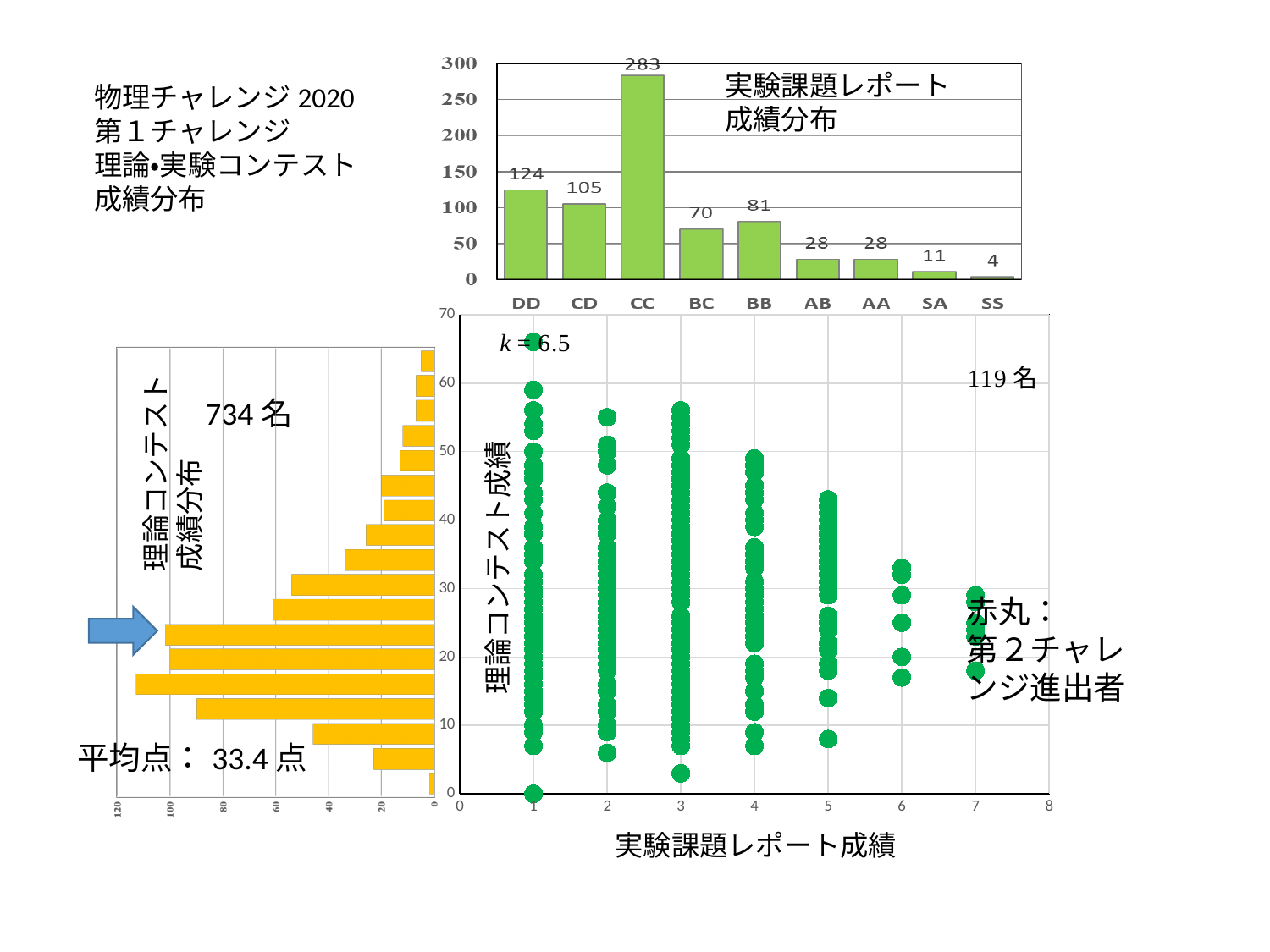
In the top bar chart 実験課題レポート成績分布, what is the value for CC? 283 What kind of chart is the chart on the left titled 理論コンテスト成績分布? bar chart What kind of chart is the large chart at the bottom right plotting 理論コンテスト成績 against 実験課題レポート成績? scatter chart In the top bar chart 実験課題レポート成績分布, what is the value for DD? 124 In the top bar chart 実験課題レポート成績分布, which category has the lowest value? SS In the top bar chart 実験課題レポート成績分布, what is the value for SA? 11 In the top bar chart 実験課題レポート成績分布, which is larger, the value for BB or the value for BC? BB In the top bar chart 実験課題レポート成績分布, which category has the highest value? CC In the top bar chart 実験課題レポート成績分布, how many categories are shown on the x axis? 9 In the top bar chart 実験課題レポート成績分布, what is the difference between the values for DD and CD? 19 What kind of chart is the top chart 実験課題レポート成績分布? bar chart In the scatter chart at the bottom right, what is the x-axis title? 実験課題レポート成績